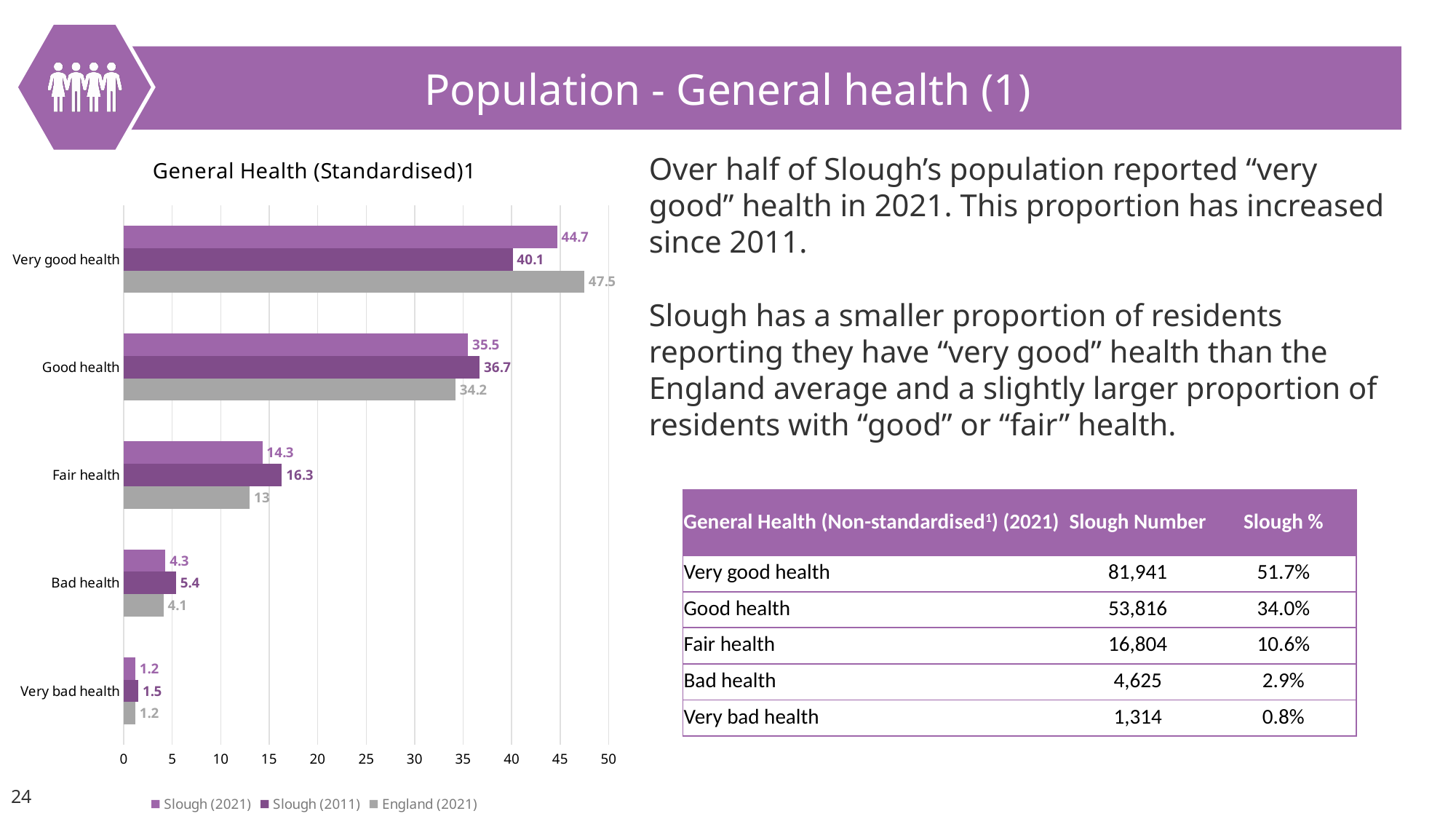
Which category has the lowest value in the England (2021) series? Very bad health What is the value for Very good health in the Slough (2021) series? 44.7 What is the difference between the England (2021) and Slough (2021) values for Very good health? 2.8 What is the value for Fair health in the Slough (2011) series? 16.3 Which category has the highest value in the Slough (2021) series? Very good health For Bad health, which is larger: the Slough (2011) value or the Slough (2021) value? Slough (2011) What is the title of the chart? General Health (Standardised)1 What is the value for Good health in the England (2021) series? 34.2 What is the difference between the Slough (2011) and Slough (2021) values for Good health? 1.2 How many series does the chart legend list? 3 How many health categories are shown on the chart? 5 What kind of chart is shown on the slide? Bar chart